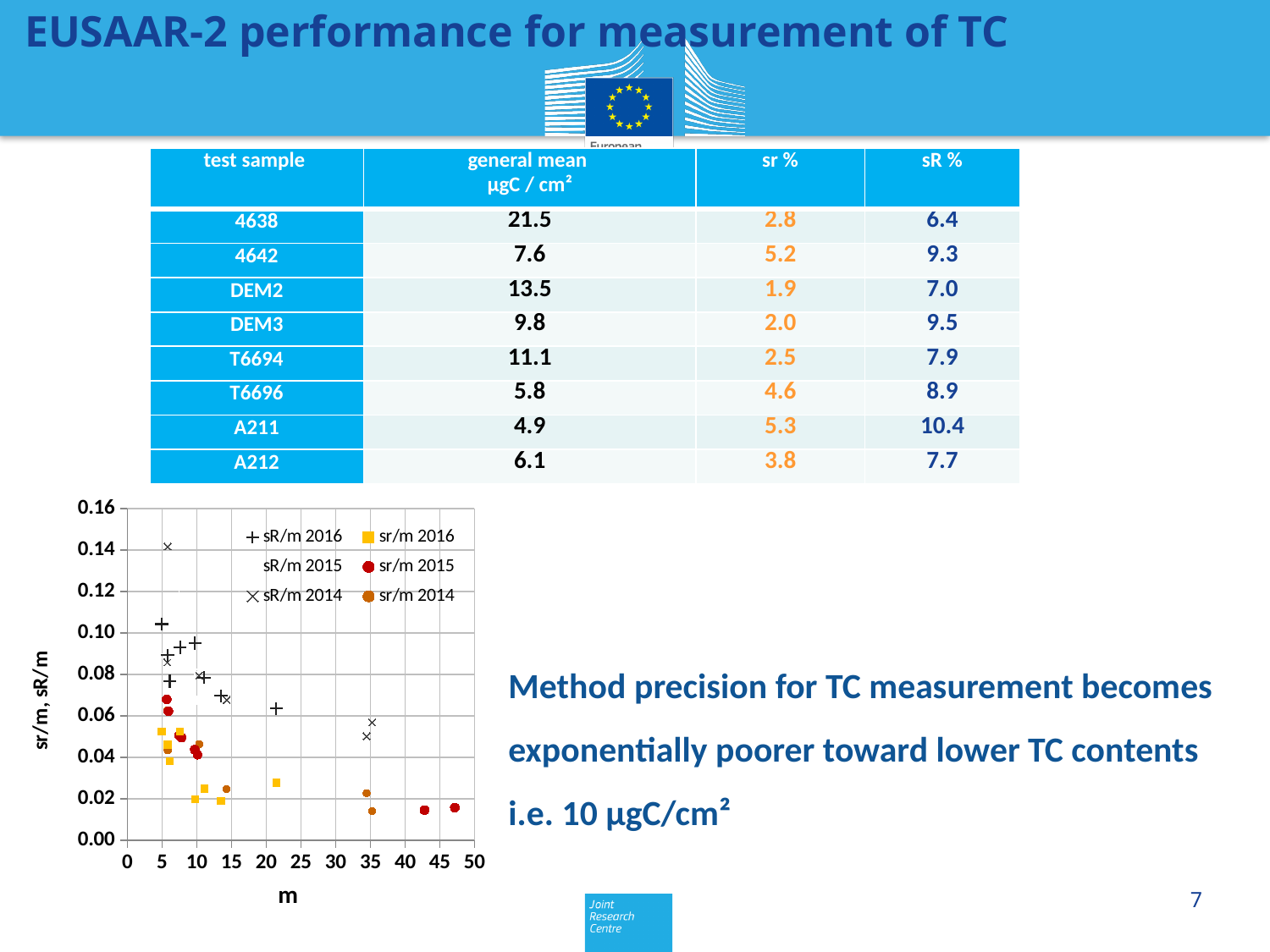
How many series does the chart legend list? 6 Do the sR/m values generally rise or fall as m increases along the x axis? fall What kind of chart is shown on the slide? scatter chart What is the label of the x axis of the chart? m Is the sR/m 2016 point near m = 21 greater or less than 0.04? greater Is the highest sR/m 2014 point on the chart greater or less than 0.12? greater Is the sr/m 2015 point near m = 47 greater or less than 0.04? less Which is larger at m ≈ 35: the sR/m 2014 value or the sr/m 2014 value? sR/m 2014 Which series has the highest plotted point on the chart? sR/m 2014 What is the maximum value shown on the y axis of the chart? 0.16 What is the label of the y axis of the chart? sr/m, sR/m